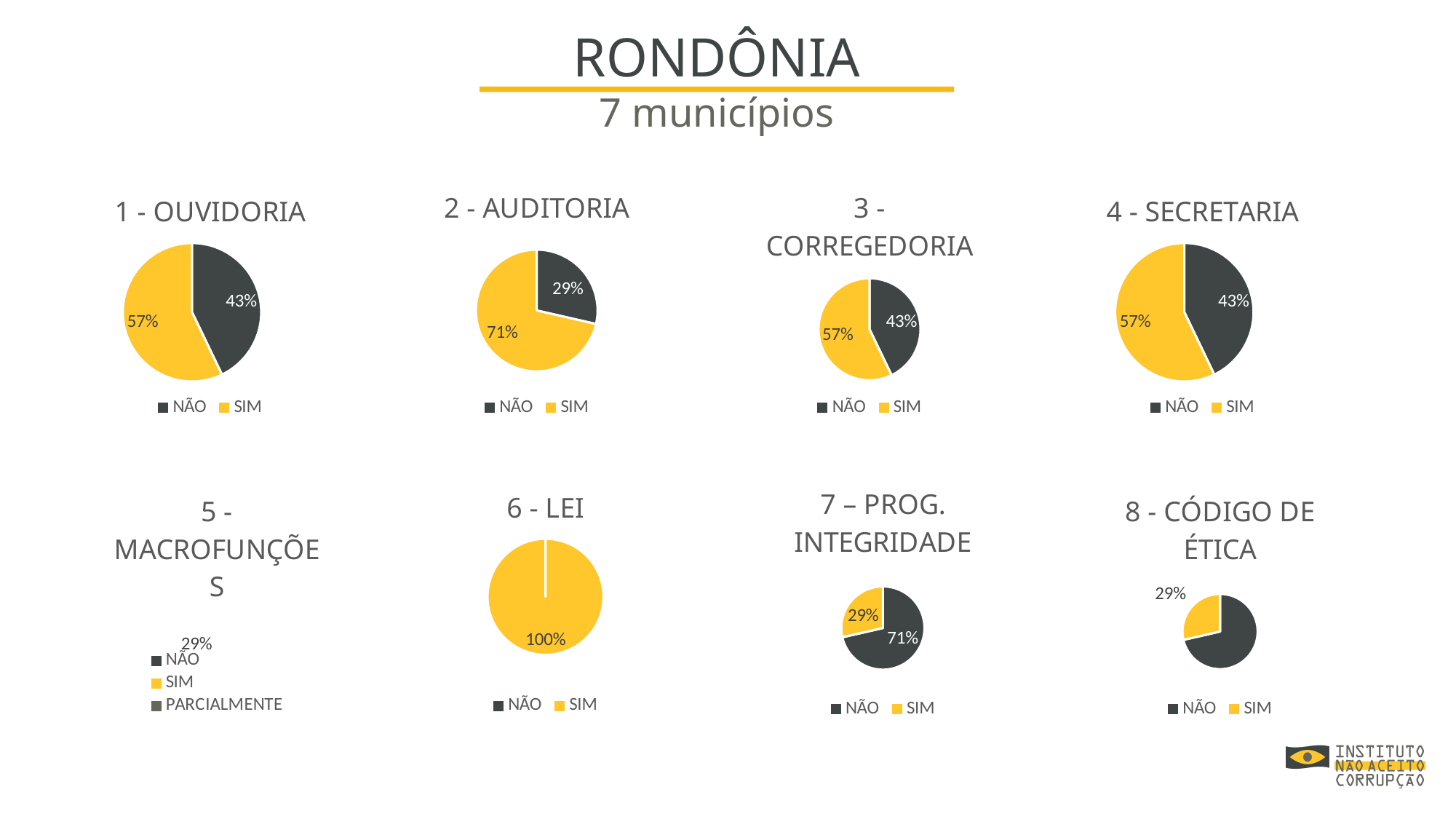
In the "4 - SECRETARIA" pie chart, which slice is larger, SIM or NÃO? SIM In the "6 - LEI" pie chart, what share is SIM? 100% In the "2 - AUDITORIA" pie chart, what share is SIM? 71% In the "3 - CORREGEDORIA" pie chart, what share is NÃO? 43% In the "2 - AUDITORIA" pie chart, what is the difference between the SIM and NÃO shares? 42% What type of chart is used for "2 - AUDITORIA"? Pie chart How many entries does the legend of the "5 - MACROFUNÇÕES" chart list? 3 In the "8 - CÓDIGO DE ÉTICA" pie chart, which slice is larger, SIM or NÃO? NÃO